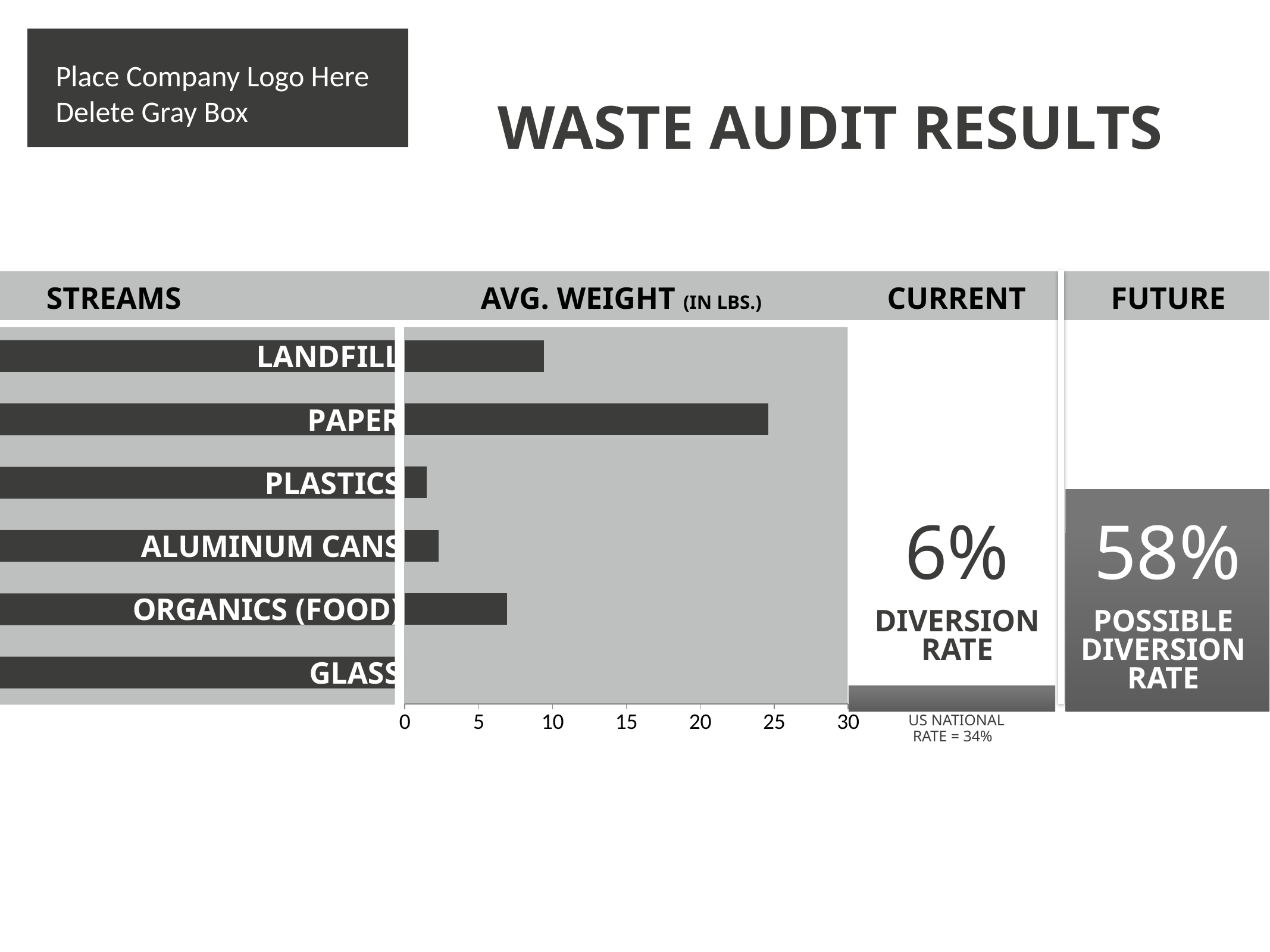
Is the average weight for Organics (Food) greater or less than 5? greater How many waste streams are listed in the bar chart? 6 Which has a higher average weight, Organics (Food) or Plastics? Organics (Food) Is the average weight for Aluminum Cans greater or less than 5? less What is the highest value shown on the chart's x axis? 30 Is the average weight for Landfill greater or less than 15? less Which waste stream has the lowest average weight? Glass What unit is the average weight measured in on the chart? lbs. What kind of chart is used to show the average weight of the waste streams? Bar chart Which waste stream has the highest average weight? Paper Which has a higher average weight, Landfill or Paper? Paper